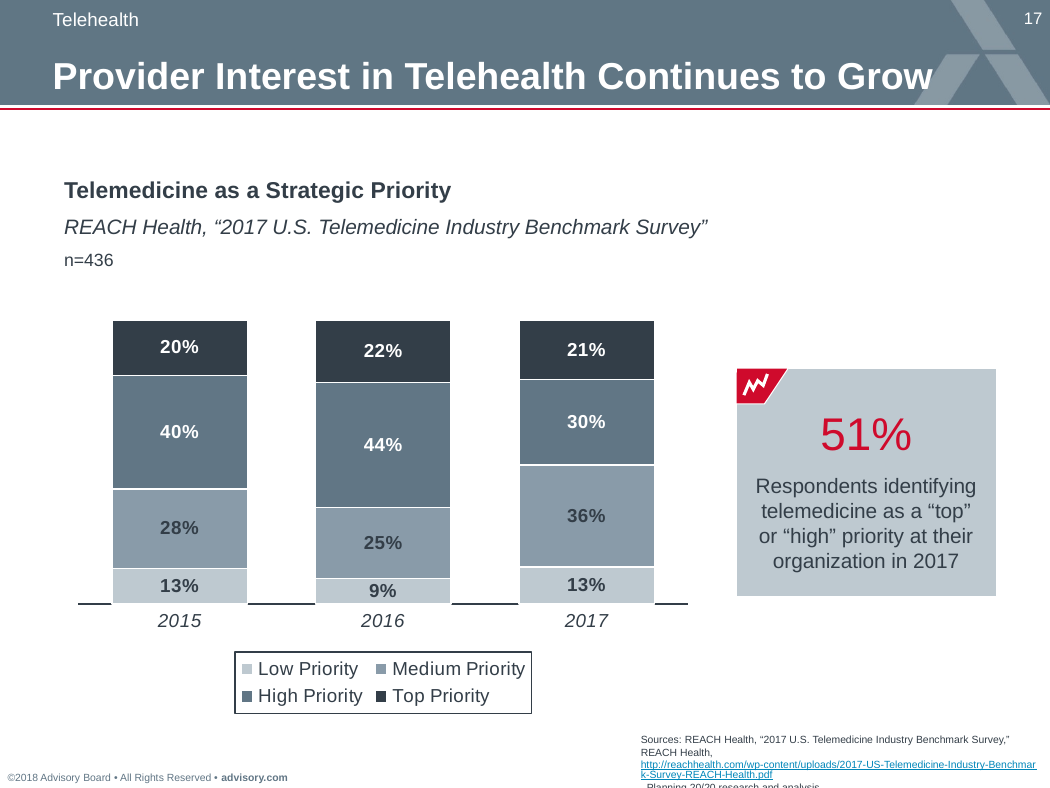
How many years are shown on the x axis of the chart? 3 What percentage of respondents rated telemedicine as a High Priority in 2016? 44% What kind of chart is used to show telemedicine as a strategic priority? Stacked bar chart In which year was the Low Priority share the lowest? 2016 What percentage of respondents rated telemedicine as a Top Priority in 2015? 20% How many series does the chart legend list? 4 What percentage of respondents rated telemedicine as a Medium Priority in 2017? 36% In which year was the High Priority share the highest? 2016 What is the combined share of Top Priority and High Priority responses in 2017? 51% Which is larger: the High Priority share in 2015 or in 2017? 2015 What percentage of respondents rated telemedicine as a Low Priority in 2016? 9% What is the difference between the Medium Priority share in 2017 and in 2016? 11%